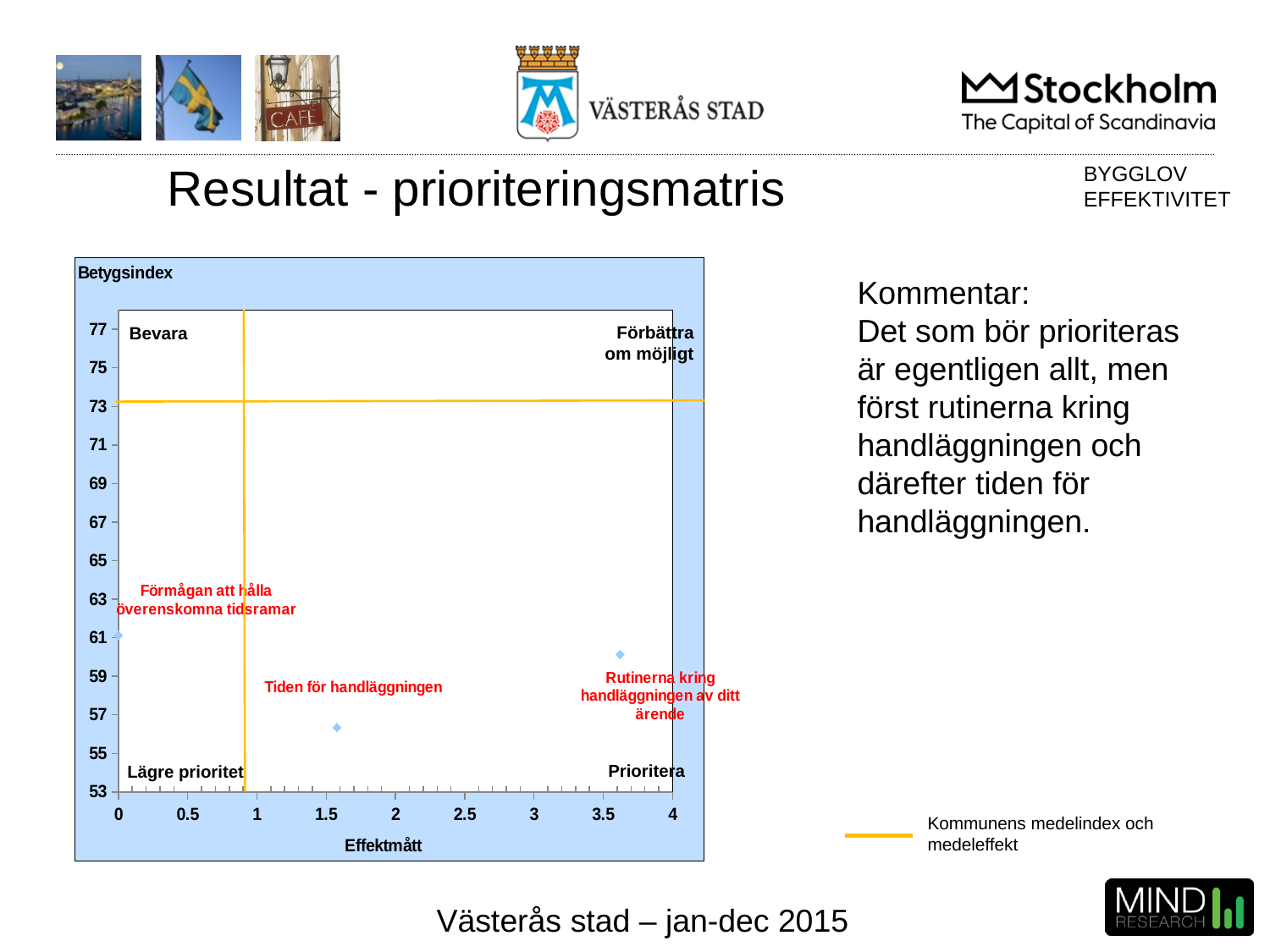
Is the Betygsindex value for Tiden för handläggningen greater or less than 59? less What kind of chart is shown on the slide? scatter chart Is the Betygsindex value for Förmågan att hålla överenskomna tidsramar greater or less than 59? greater Which point has the lowest Effektmått value? Förmågan att hålla överenskomna tidsramar What is the title of the x axis of the chart? Effektmått Is the Effektmått value for Tiden för handläggningen greater or less than 2? less Which point has the lowest Betygsindex value? Tiden för handläggningen Which point has the highest Effektmått value? Rutinerna kring handläggningen av ditt ärende In which quadrant of the matrix does the point Rutinerna kring handläggningen av ditt ärende lie? Prioritera Which has a higher Effektmått value, Tiden för handläggningen or Rutinerna kring handläggningen av ditt ärende? Rutinerna kring handläggningen av ditt ärende How many data points are plotted in the chart? 3